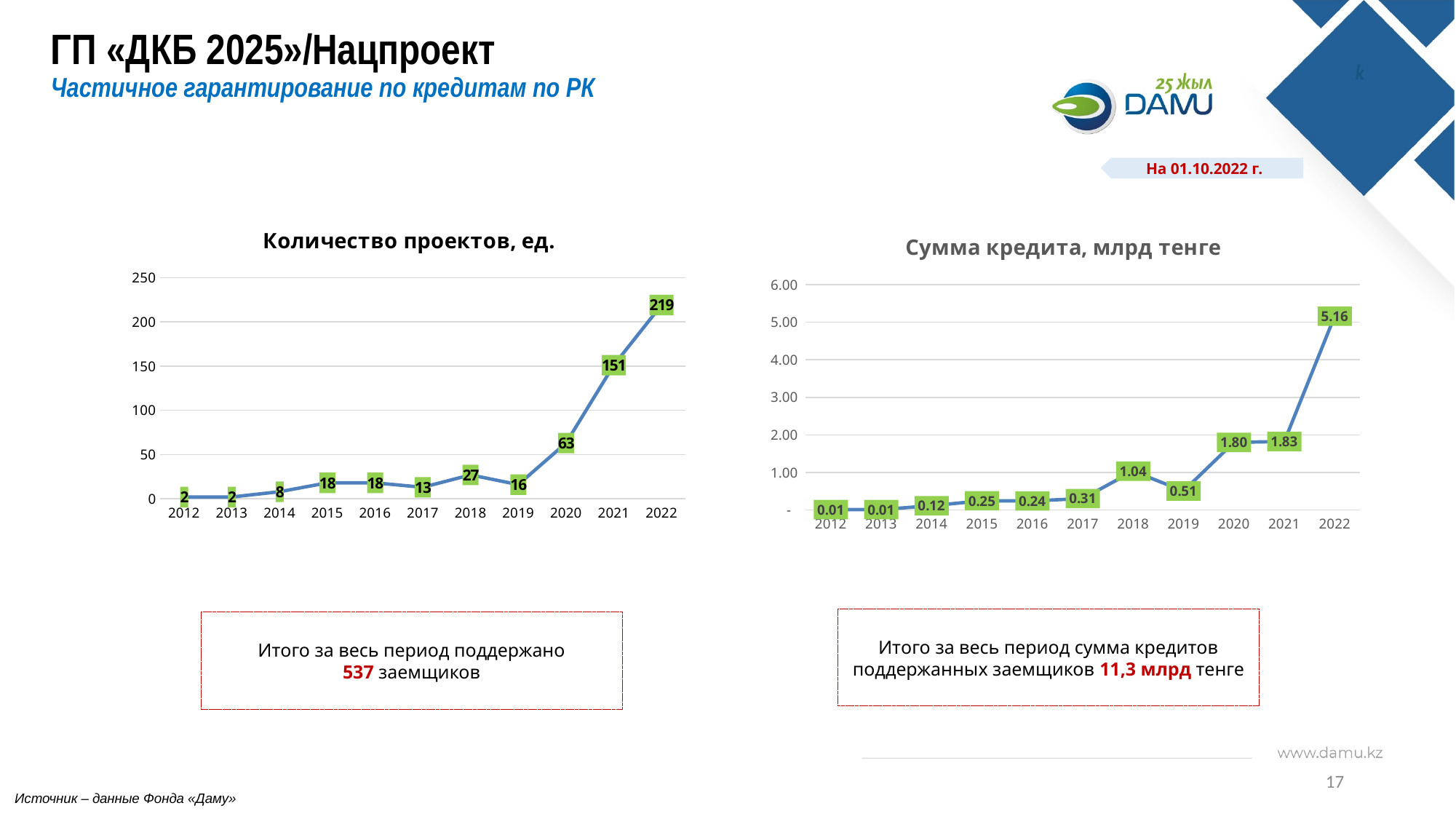
In the chart titled "Сумма кредита, млрд тенге", what is the value for 2020? 1.80 In the chart titled "Сумма кредита, млрд тенге", is the value for 2022 greater or less than 5.00? greater In the chart titled "Сумма кредита, млрд тенге", what is the value for 2018? 1.04 In the chart titled "Количество проектов, ед.", what is the value for 2021? 151 In the chart titled "Сумма кредита, млрд тенге", which year has the highest value? 2022 In the chart titled "Количество проектов, ед.", which year has the highest value? 2022 In the chart titled "Количество проектов, ед.", what is the value for 2018? 27 In the chart titled "Количество проектов, ед.", what is the difference between the values for 2022 and 2021? 68 In the chart titled "Сумма кредита, млрд тенге", what is the difference between the values for 2022 and 2021? 3.33 In the chart titled "Количество проектов, ед.", which is larger, the value for 2017 or the value for 2019? 2019 What type of chart is the chart titled "Сумма кредита, млрд тенге"? line chart In the chart titled "Количество проектов, ед.", how many years are plotted? 11